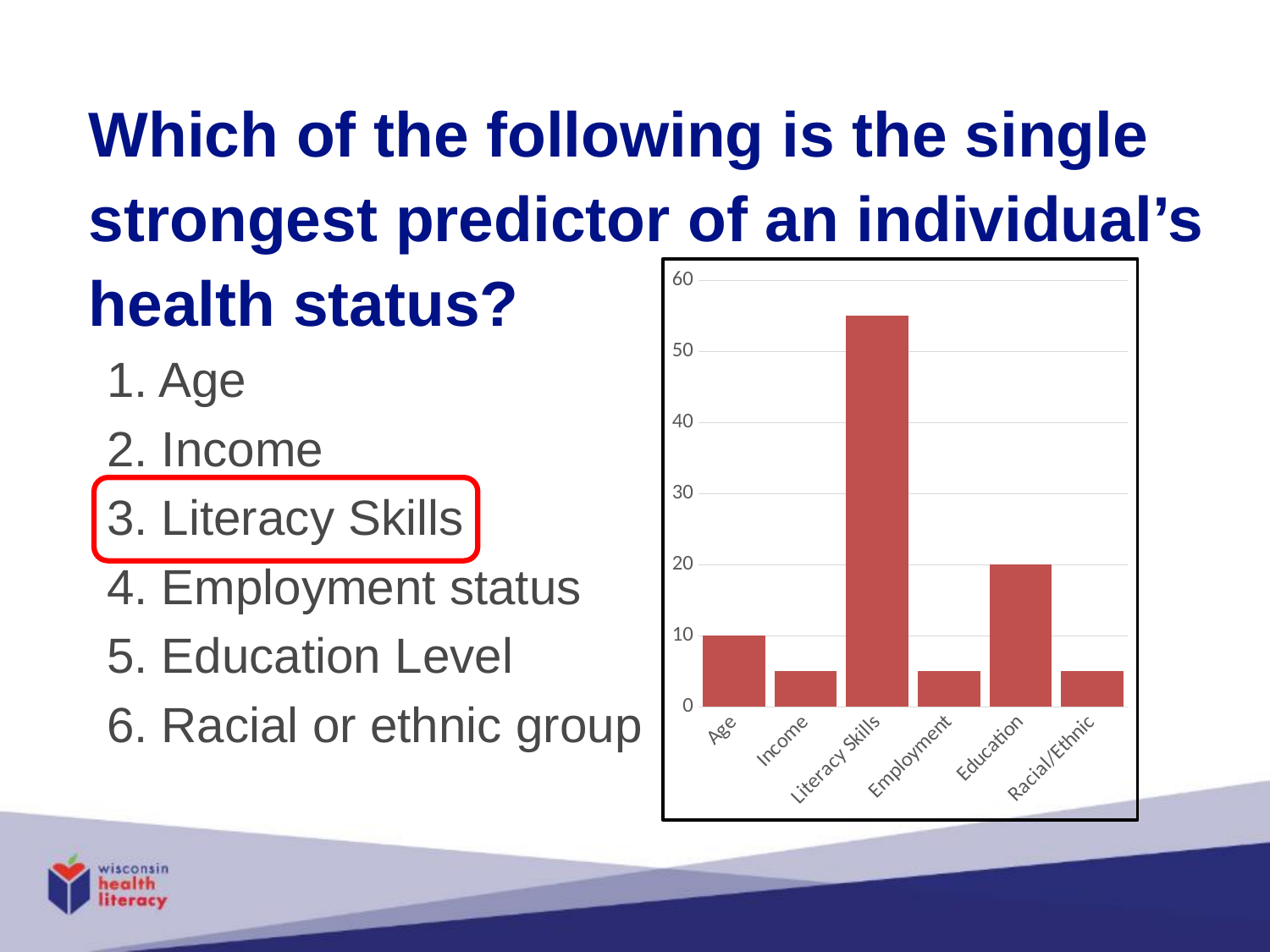
What is the difference between the values for Education and Age in the chart? 10 Is the value for Employment greater or less than 10? less What is the value for Age in the chart? 10 Which is larger in the chart, the value for Education or the value for Age? Education How many categories are shown on the x axis of the chart? 6 Is the value for Literacy Skills greater or less than 50? greater Which category has the highest bar in the chart? Literacy Skills What colour are the bars in the chart? red What is the value for Education in the chart? 20 What kind of chart is shown on the slide? bar chart Is the value for Racial/Ethnic greater or less than 10? less